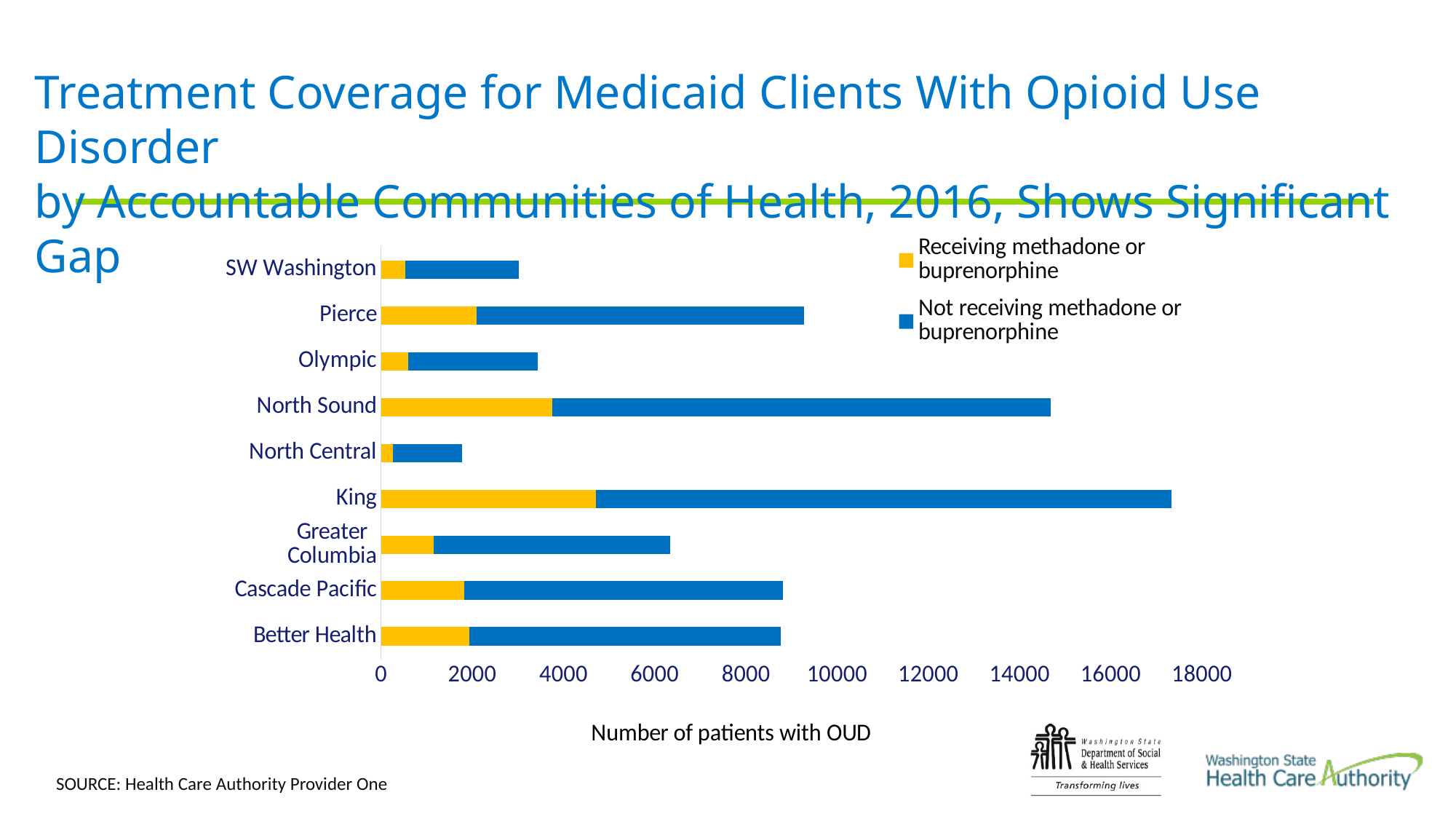
What kind of chart is shown on the slide? Stacked bar chart Which Accountable Community of Health has the highest total number of patients with OUD? King Which has a larger total number of patients with OUD, North Sound or Pierce? North Sound Is the total number of patients with OUD for North Central greater or less than 2000? less How many series does the legend list? 2 Which Accountable Community of Health has the lowest total number of patients with OUD? North Central Is the total number of patients with OUD for Olympic greater or less than 4000? less How many Accountable Communities of Health (categories) are plotted on the chart? 9 Which has a larger total number of patients with OUD, Pierce or Olympic? Pierce Is the total number of patients with OUD for King greater or less than 16000? greater What is the title of the horizontal axis of the chart? Number of patients with OUD